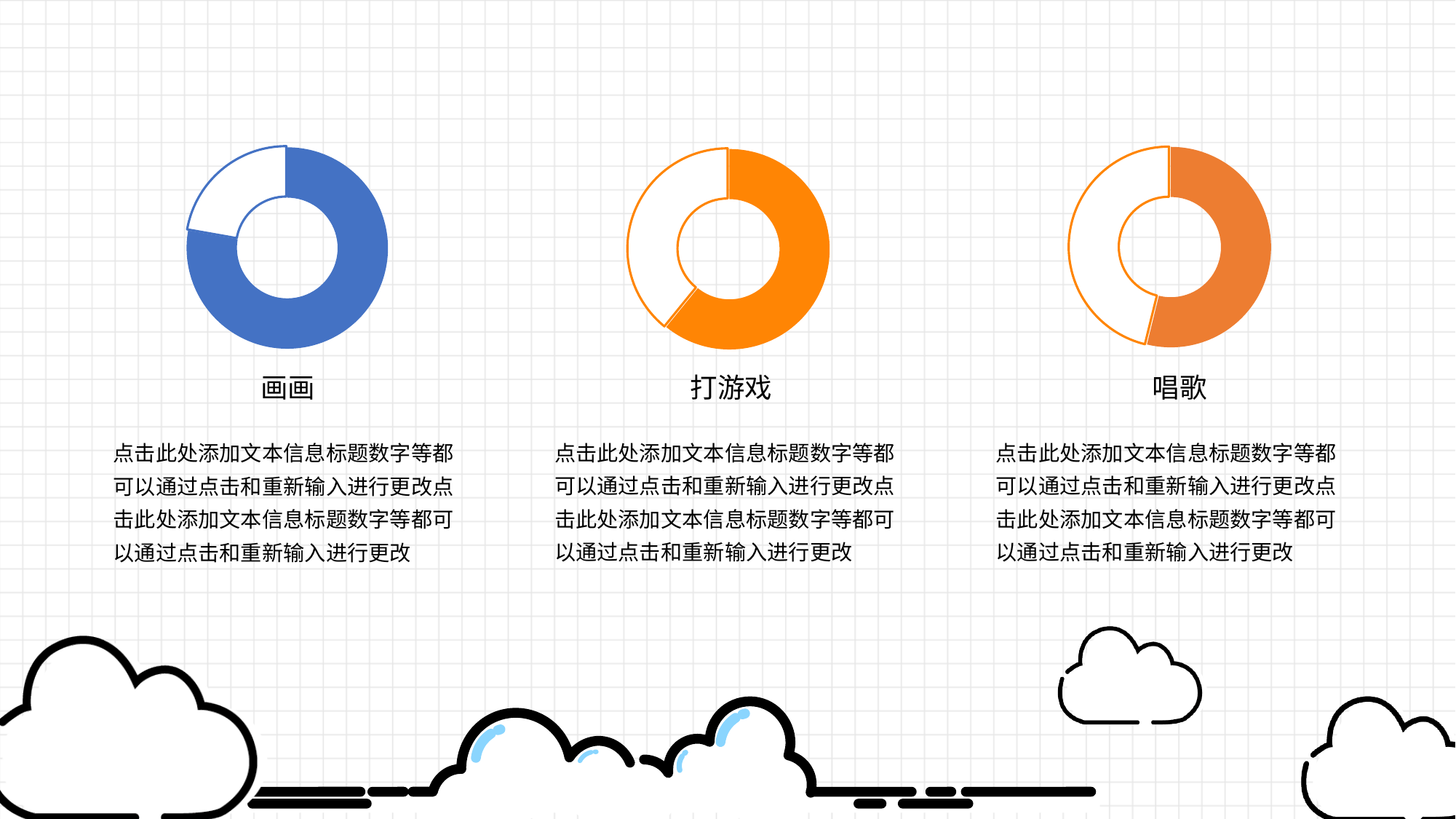
How many slices does each doughnut chart contain? 2 Which of the three doughnut charts has the smallest filled (coloured) portion? 唱歌 In the 打游戏 doughnut chart, which is larger: the orange filled portion or the white portion? the orange filled portion Which doughnut chart has a larger filled portion, 画画 or 唱歌? 画画 What is the label under the leftmost doughnut chart? 画画 In the 画画 doughnut chart, which is larger: the blue filled portion or the white portion? the blue filled portion How many doughnut charts are on the slide? 3 Which of the three doughnut charts has the largest filled (coloured) portion? 画画 What is the label under the middle doughnut chart? 打游戏 What kind of chart is shown under the label 画画? doughnut chart